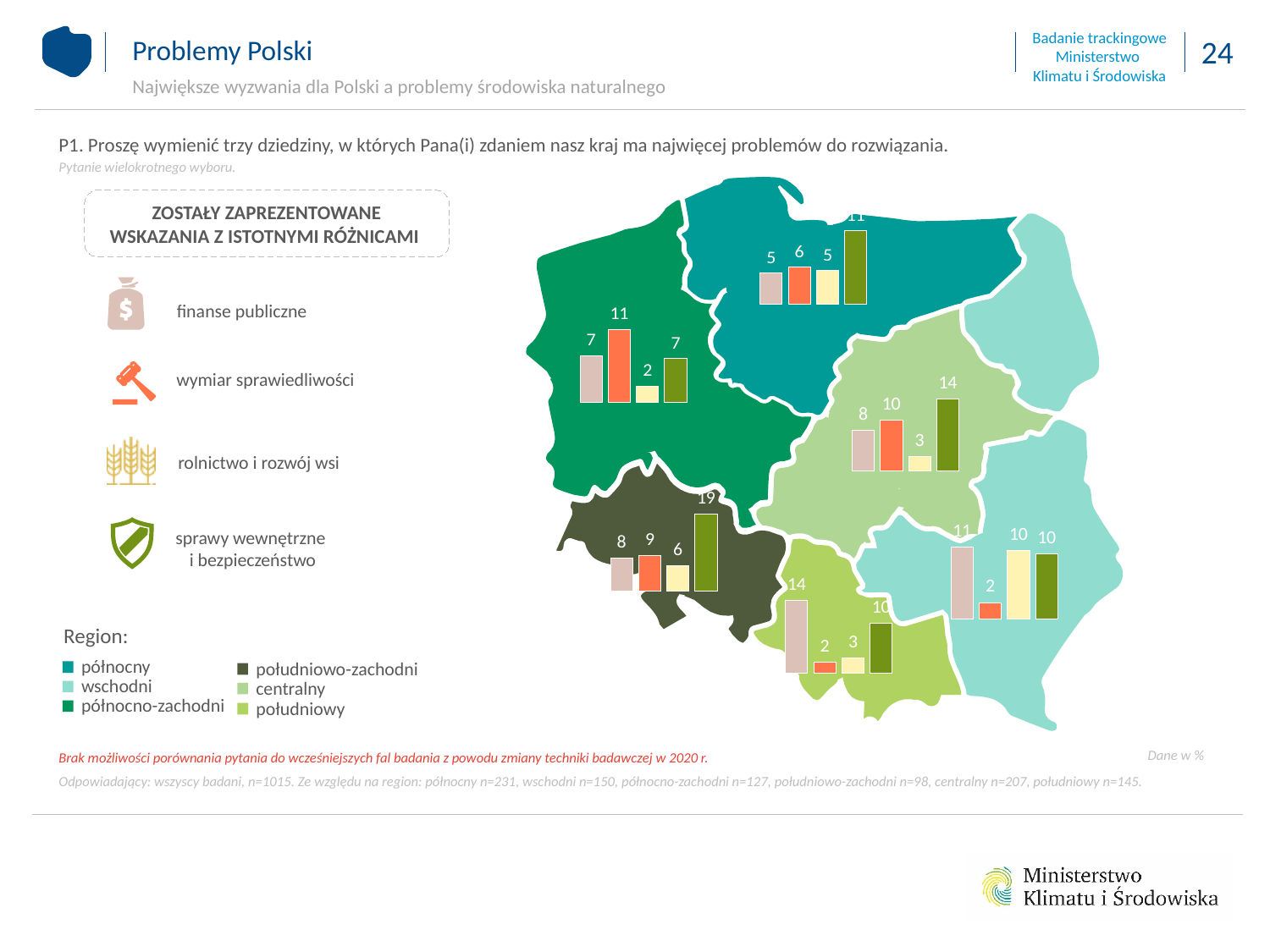
In the północny region chart, which category has the highest value? sprawy wewnętrzne i bezpieczeństwo In the centralny region chart, which category has the lowest value? rolnictwo i rozwój wsi In the wschodni region chart, what is the value for wymiar sprawiedliwości (orange bar)? 2 How many bars are shown in each region's chart? 4 In the południowy region chart, what is the value for finanse publiczne (beige bar)? 14 How many regions are listed in the Region legend? 6 In the centralny region chart, what is the value for wymiar sprawiedliwości (orange bar)? 10 What type of chart is used for each region on the map? bar chart Which is larger: the value for finanse publiczne in the południowy region or in the północny region? południowy In the północno-zachodni region chart, which category has the highest value? wymiar sprawiedliwości In the południowo-zachodni region chart, what is the difference between sprawy wewnętrzne i bezpieczeństwo and finanse publiczne? 11 In the południowo-zachodni region chart, what is the value for sprawy wewnętrzne i bezpieczeństwo (green bar)? 19